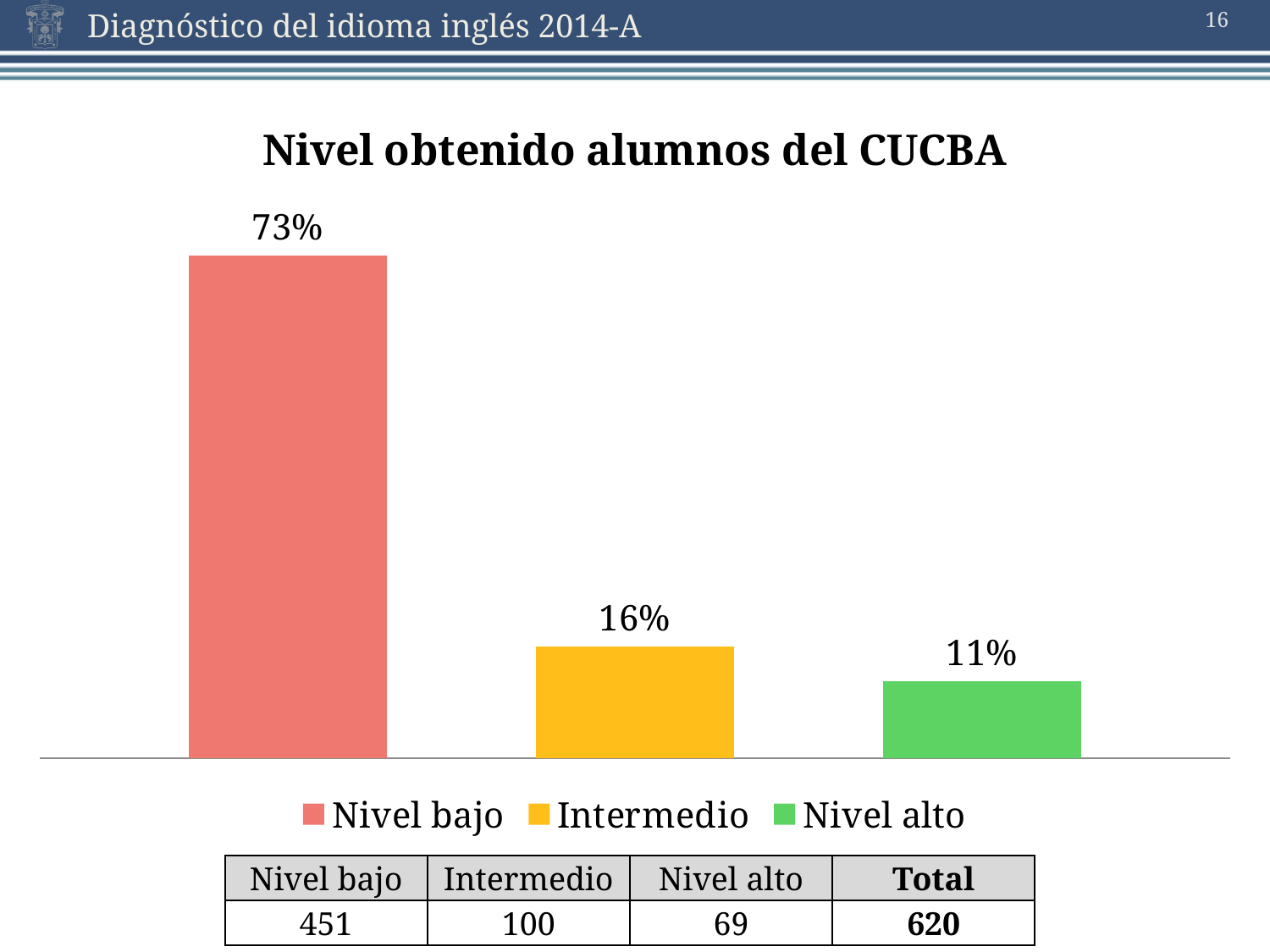
What is the value for Intermedio? 16% Which category has the lowest value? Nivel alto What is the value for Nivel alto? 11% What kind of chart is shown on the slide? Bar chart How many categories are shown in the chart? 3 What is the title of the chart? Nivel obtenido alumnos del CUCBA What is the difference between the values for Nivel bajo and Intermedio? 57% Which is larger, the value for Intermedio or the value for Nivel alto? Intermedio What is the difference between the values for Intermedio and Nivel alto? 5% Which category has the highest value? Nivel bajo How many entries does the legend list? 3 What is the value for Nivel bajo? 73%